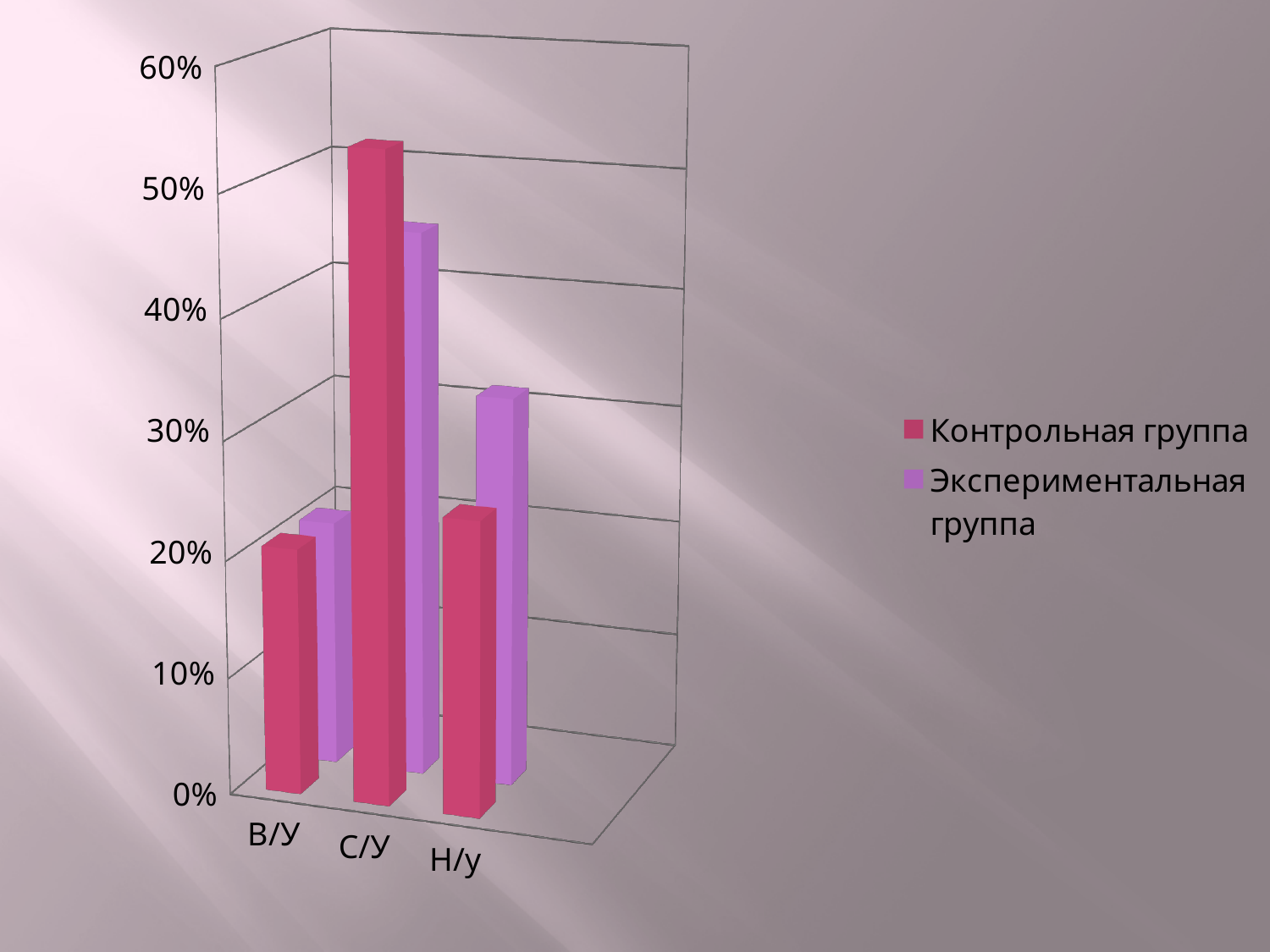
For Н/у, which series has the larger value: Контрольная группа or Экспериментальная группа? Экспериментальная группа How many series does the legend list? 2 Which category has the highest value for Контрольная группа? С/У Which category has the lowest value for Экспериментальная группа? В/У What kind of chart is shown on the slide? bar chart Is the value for Контрольная группа at С/У greater or less than 50%? greater Is the value for Контрольная группа at В/У greater or less than 30%? less How many categories are shown on the x axis of the chart? 3 Which category has the highest value for Экспериментальная группа? С/У For С/У, which series has the larger value: Контрольная группа or Экспериментальная группа? Контрольная группа Is the value for Экспериментальная группа at С/У greater or less than 40%? greater What are the two series named in the legend? Контрольная группа and Экспериментальная группа